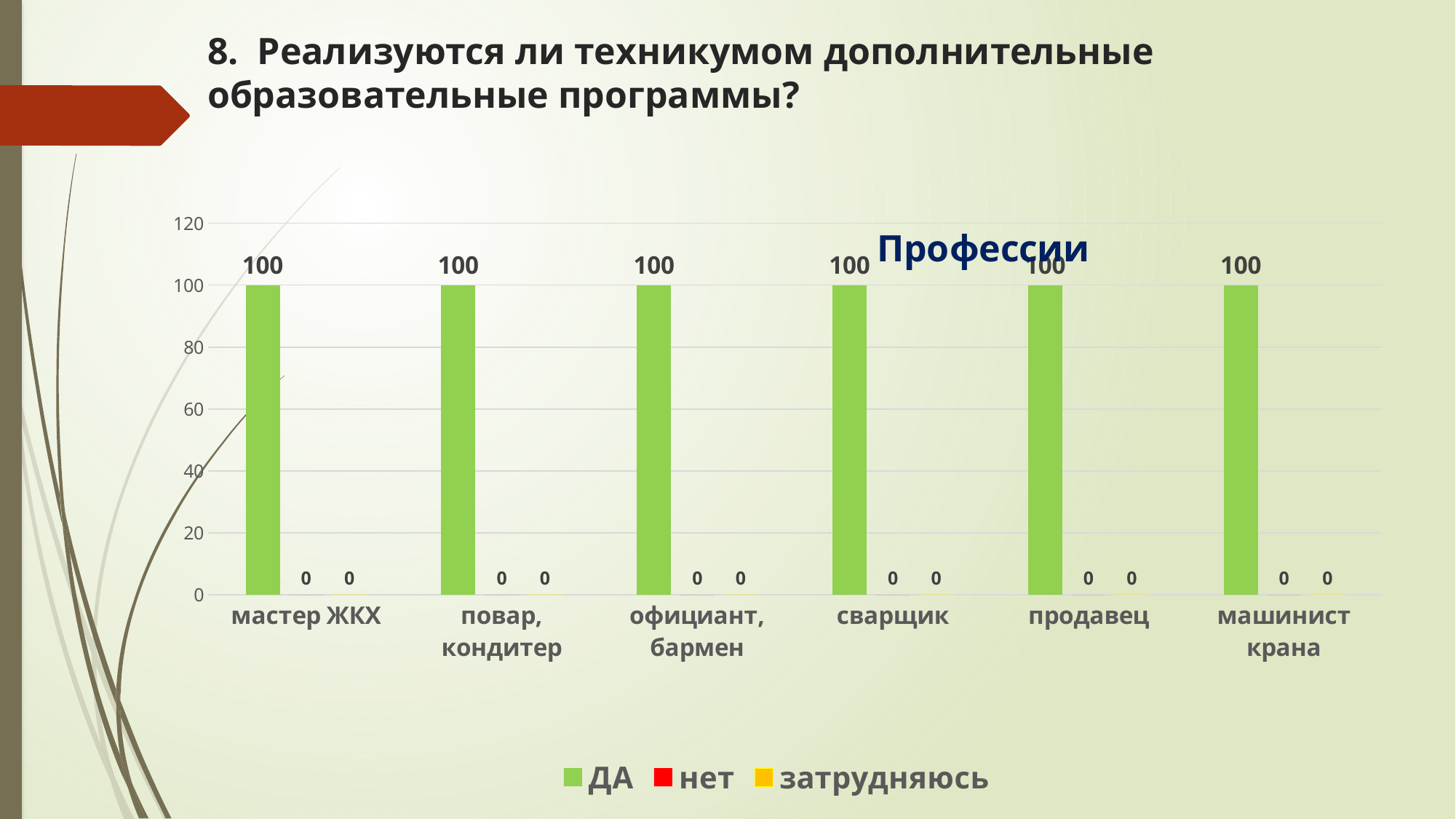
What is the title of the chart? Профессии What is the value of the "затрудняюсь" series for "продавец"? 0 What is the value of the "ДА" series for "сварщик"? 100 Is the "ДА" value for "продавец" greater or less than 80? greater What is the value of the "нет" series for "мастер ЖКХ"? 0 What kind of chart is shown on the slide? bar chart How many series does the legend list? 3 How many categories are shown on the x axis? 6 What is the value of the "ДА" series for "машинист крана"? 100 Which is larger for "официант, бармен": the "ДА" value or the "затрудняюсь" value? ДА What colour represents the "ДА" series in the legend? green What is the difference between the "ДА" value and the "нет" value for "повар, кондитер"? 100